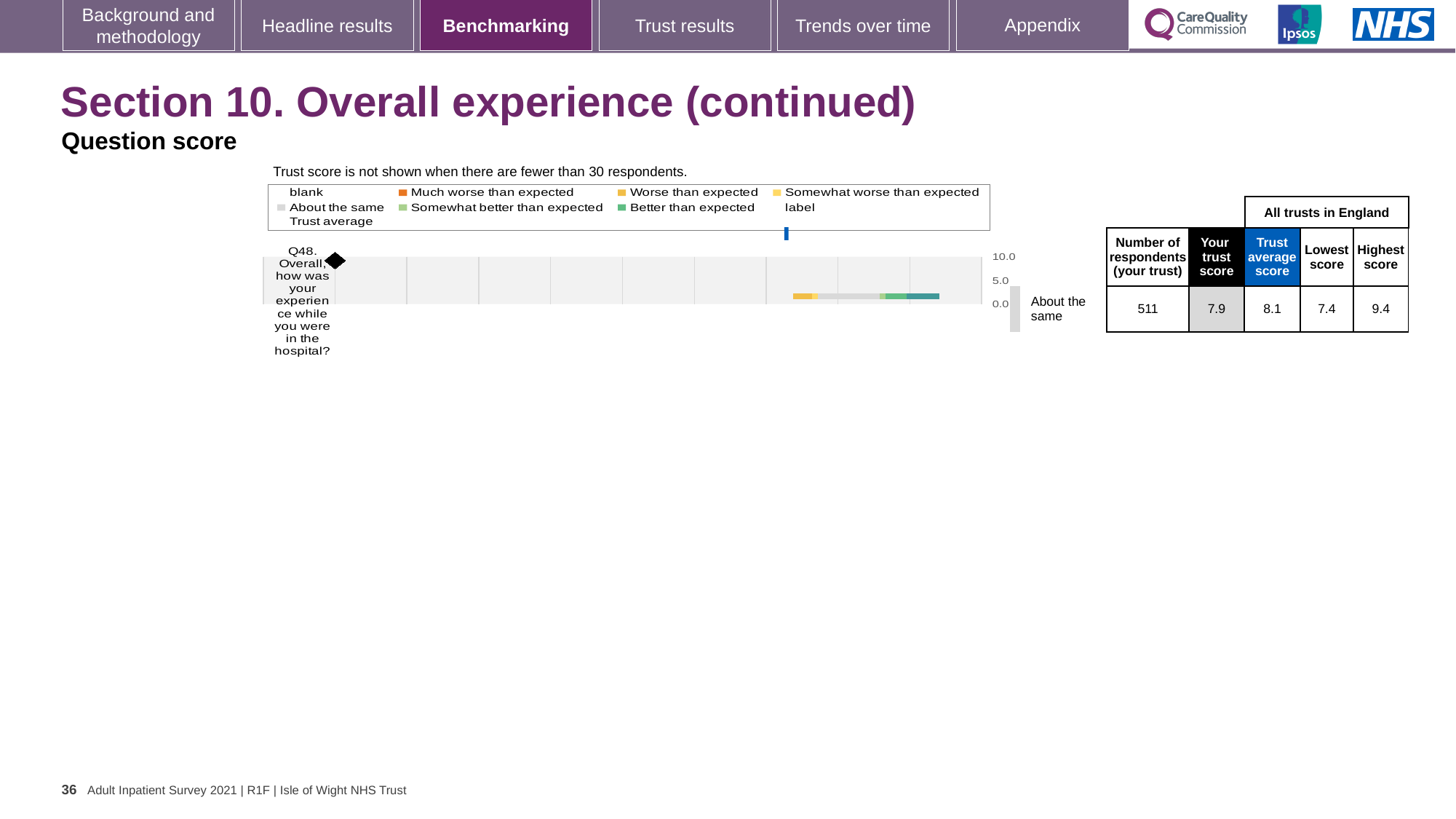
Which is larger for Q48, your trust score or the trust average score? Trust average score What benchmark category is shown next to the Q48 bar? About the same How many survey questions are plotted on the chart? 1 Below how many respondents is the trust score not shown, according to the note above the chart? 30 What is the 'Trust average score' for Q48? 8.1 What kind of chart is used to show the Q48 benchmarking result? bar chart How many respondents from your trust answered Q48? 511 What is the 'Your trust score' for Q48? 7.9 What is the 'Lowest score' across all trusts in England for Q48? 7.4 What is the difference between the highest score and the lowest score for Q48? 2.0 What is the 'Highest score' across all trusts in England for Q48? 9.4 Which question number is shown on the chart? Q48